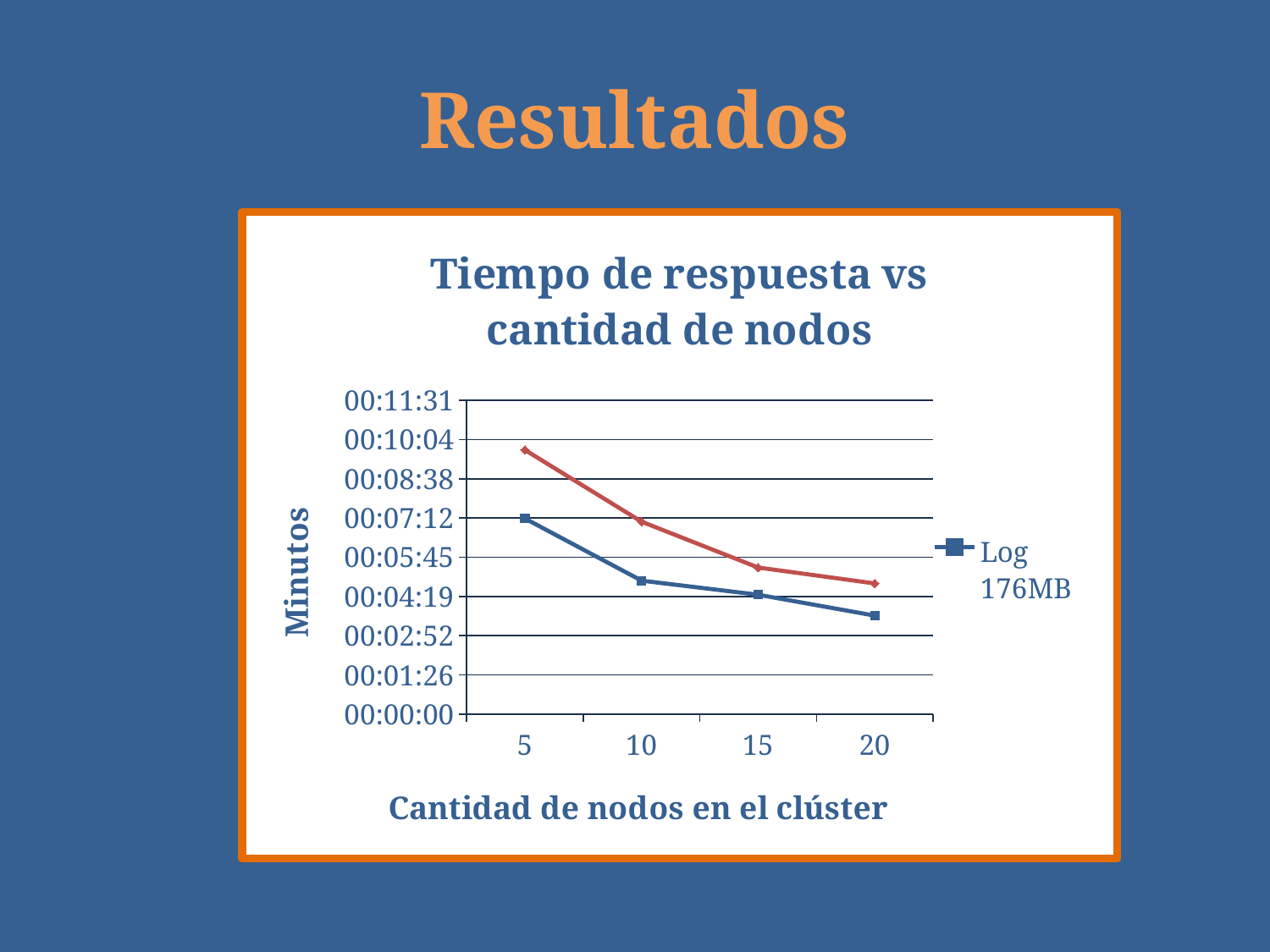
How many node counts are plotted along the x axis? 4 What is the title of the chart? Tiempo de respuesta vs cantidad de nodos At 10 nodes, which line shows the larger response time, the red line or the Log 176MB line? the red line Does the Log 176MB response time rise or fall as the number of nodes increases? fall Is the Log 176MB value at 20 nodes greater or less than 00:04:19? less What kind of chart is shown on the slide? line chart What is the label of the x axis? Cantidad de nodos en el clúster Is the red line's value at 5 nodes greater or less than 00:08:38? greater Is the Log 176MB value at 5 nodes greater or less than 00:05:45? greater At which number of nodes is the Log 176MB response time highest? 5 How many series does the legend list? 1 At which number of nodes is the Log 176MB response time lowest? 20